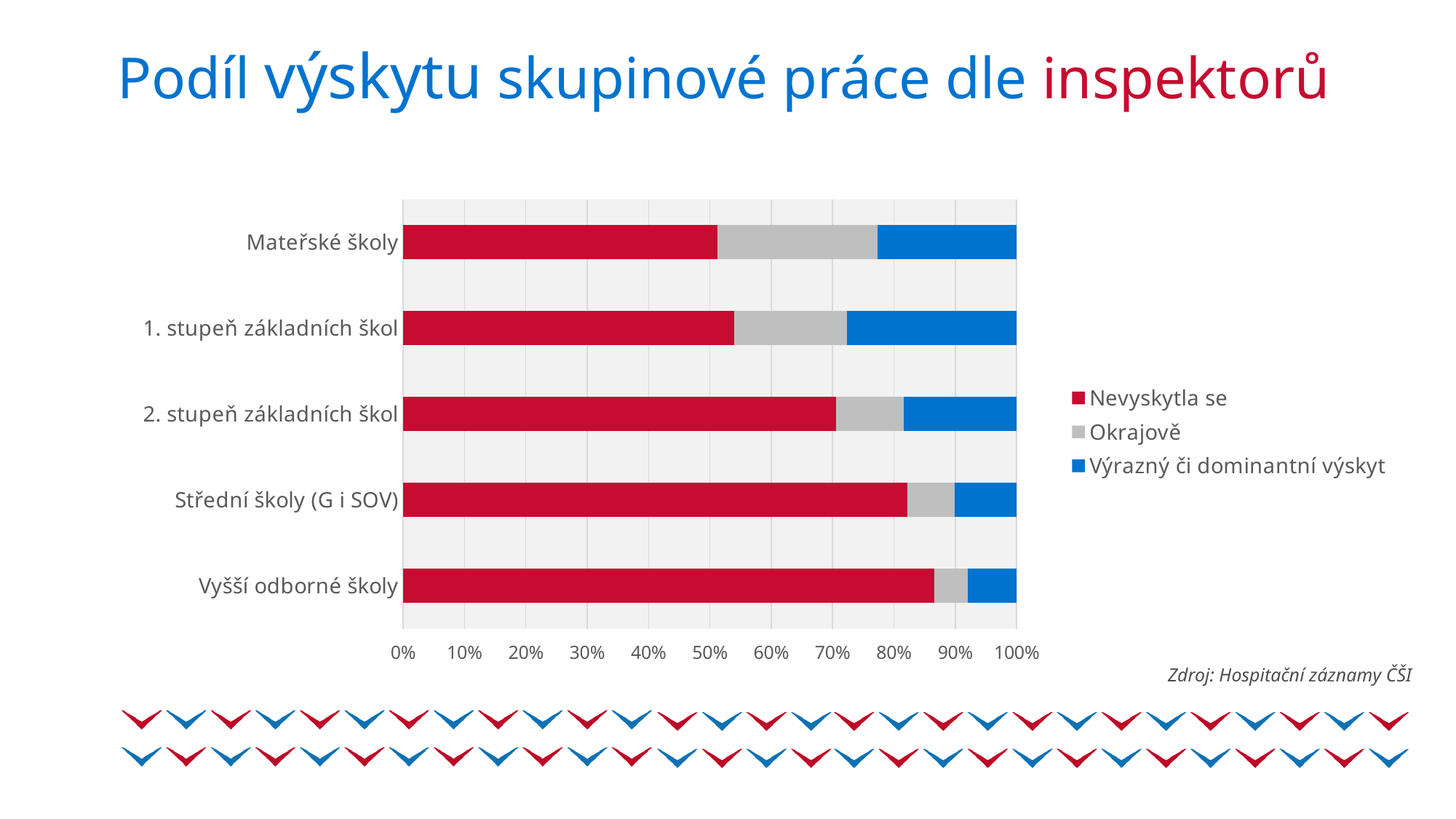
Is the 'Nevyskytla se' value for 2. stupeň základních škol greater or less than 60%? greater What kind of chart is shown on the slide? Stacked bar chart Which has the larger 'Nevyskytla se' share: Střední školy (G i SOV) or 1. stupeň základních škol? Střední školy (G i SOV) How many series does the legend list? 3 Is the 'Nevyskytla se' value for Mateřské školy greater or less than 60%? less What colour represents the 'Okrajově' series in the chart? Grey Which category has the smallest 'Nevyskytla se' share? Mateřské školy Is the 'Nevyskytla se' value for Střední školy (G i SOV) greater or less than 70%? greater Which category has the largest 'Nevyskytla se' share? Vyšší odborné školy Which category has the largest 'Výrazný či dominantní výskyt' share? 1. stupeň základních škol What is the total of the stacked bar for Mateřské školy? 100% How many school categories are plotted on the chart? 5